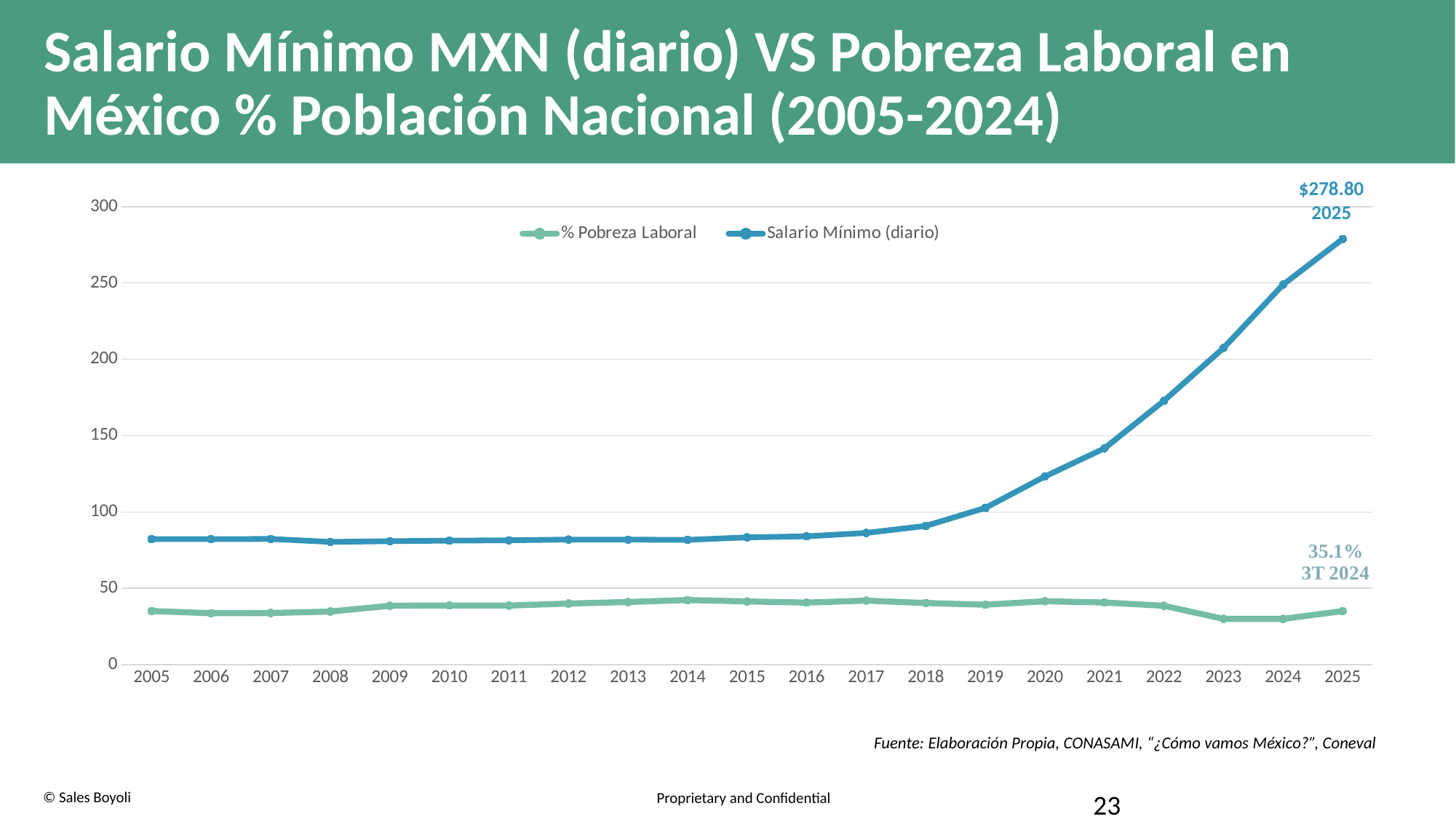
How many series does the legend list? 2 Which is larger, Salario Mínimo (diario) in 2024 or in 2020? 2024 How many years are shown on the x axis? 21 Does Salario Mínimo (diario) rise or fall from 2018 to 2025? Rises What colour is the Salario Mínimo (diario) line? Blue What value is labelled for % Pobreza Laboral at 3T 2024? 35.1% In which year is Salario Mínimo (diario) highest? 2025 Is the value of Salario Mínimo (diario) for 2018 greater or less than 100? less Is the value of Salario Mínimo (diario) for 2022 greater or less than 150? greater What kind of chart is shown on the slide? Line chart Is the value of Salario Mínimo (diario) for 2021 greater or less than 150? less What is the value of Salario Mínimo (diario) for 2025? $278.80